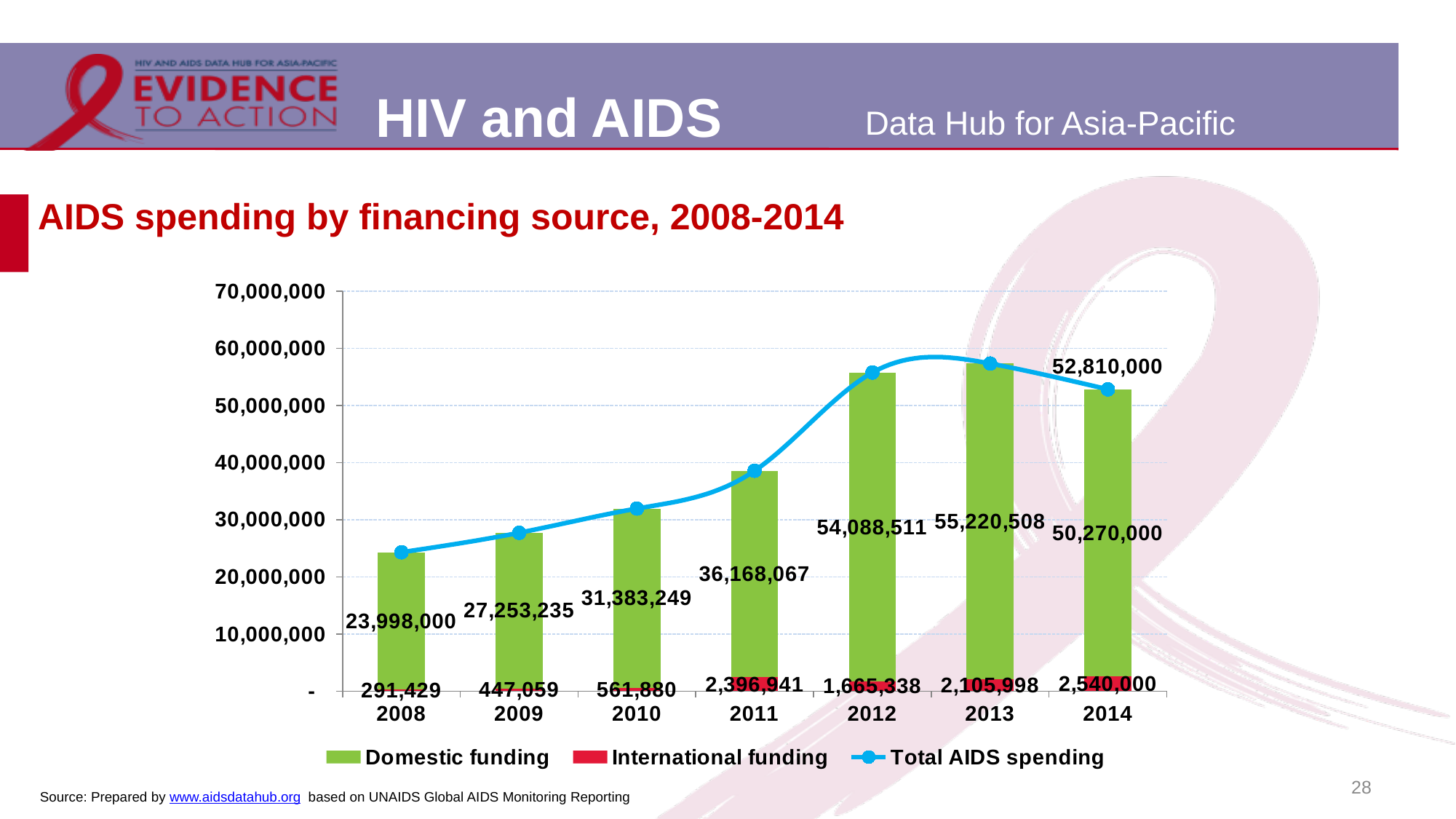
What is the International funding value for 2011? 2,396,941 Which is larger, International funding in 2011 or in 2012? 2011 How many series does the legend list? 3 How many years are shown on the x axis? 7 Is the Total AIDS spending for 2011 greater or less than 40,000,000? less What is the total of the stacked bar for 2008 (Domestic plus International funding)? 24,289,429 Which year has the highest Domestic funding? 2013 What kind of chart is this? Stacked bar chart with a line Which year has the lowest International funding? 2008 What is the difference between Domestic funding in 2013 and 2012? 1,131,997 What is the Total AIDS spending value labelled for 2014? 52,810,000 What is the Domestic funding value for 2012? 54,088,511